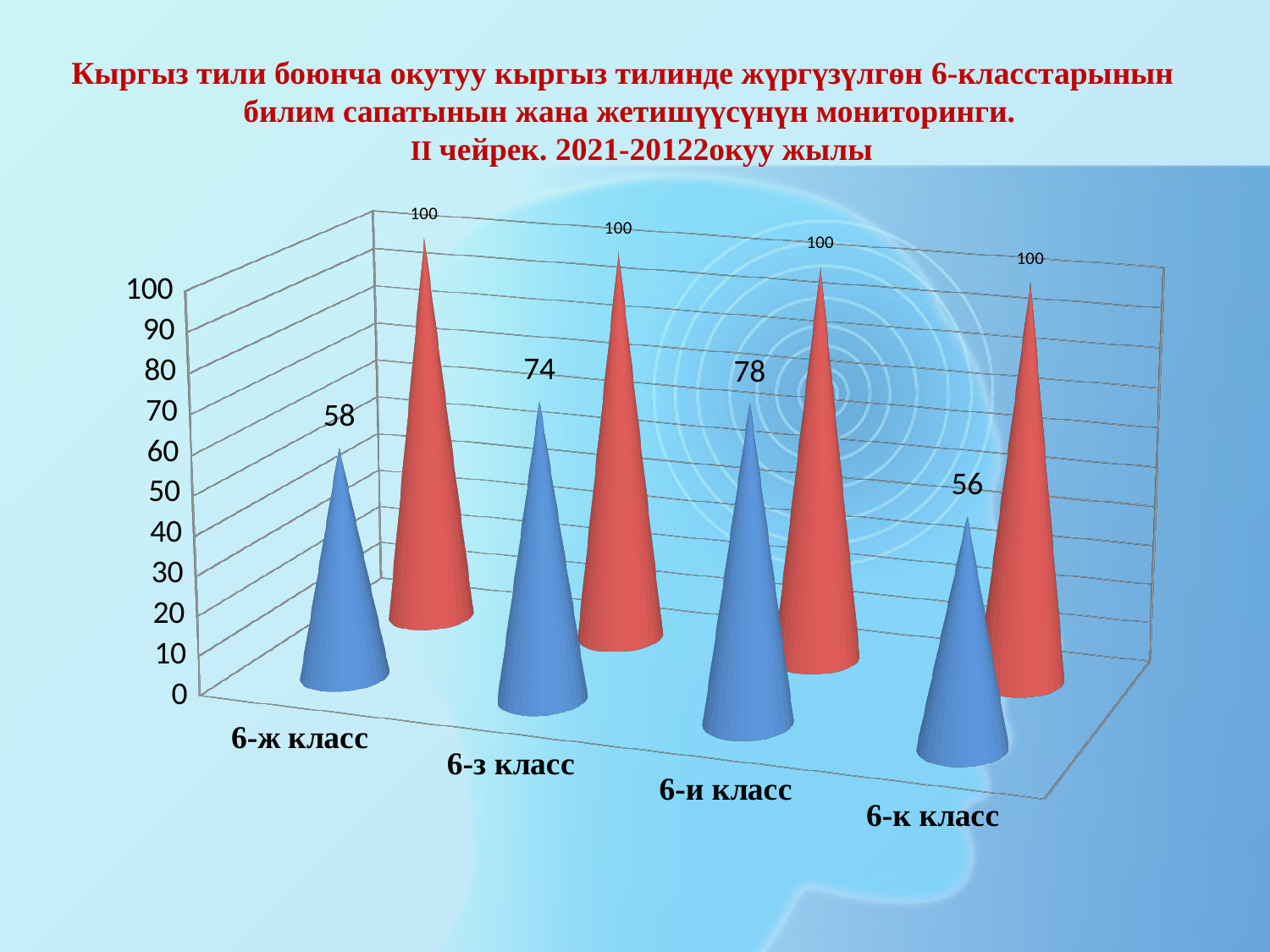
Which class has the lowest blue bar value? 6-к класс What kind of chart is shown on the slide? Bar chart What is the value of the blue bar for 6-и класс? 78 What is the value of the blue bar for 6-к класс? 56 How many data series (colours) are plotted in the chart? 2 What is the value of the red bar for 6-з класс? 100 What is the value of the blue bar for 6-з класс? 74 Which class has the highest blue bar value? 6-и класс How many classes are shown on the x axis? 4 Which is larger, the blue bar value for 6-з класс or for 6-к класс? 6-з класс What is the difference between the blue bar values for 6-и класс and 6-ж класс? 20 What is the value of the blue bar for 6-ж класс? 58